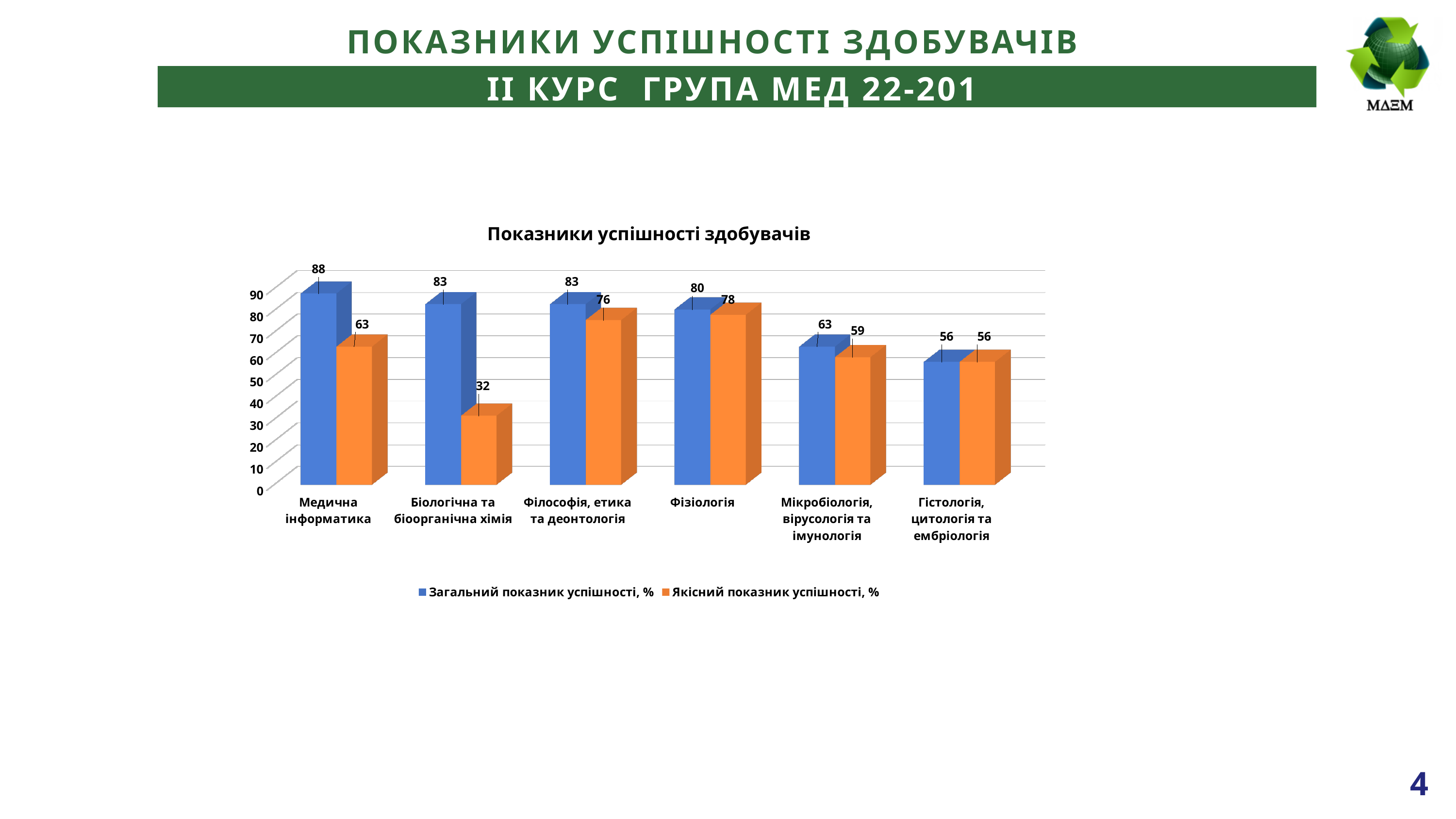
What is the difference between Загальний показник успішності, % and Якісний показник успішності, % for Біологічна та біоорганічна хімія? 51 What is the value of Загальний показник успішності, % for Медична інформатика? 88 How many series does the legend list? 2 How many categories are shown on the x axis? 6 What is the value of Якісний показник успішності, % for Біологічна та біоорганічна хімія? 32 Which category has the lowest Якісний показник успішності, %? Біологічна та біоорганічна хімія What is the value of Якісний показник успішності, % for Фізіологія? 78 What colour represents Якісний показник успішності, % in the chart? Orange Which is larger for Мікробіологія, вірусологія та імунологія: Загальний показник успішності, % or Якісний показник успішності, %? Загальний показник успішності, % What kind of chart is shown on the slide? Bar chart What is the title of the chart? Показники успішності здобувачів Which category has the highest Загальний показник успішності, %? Медична інформатика